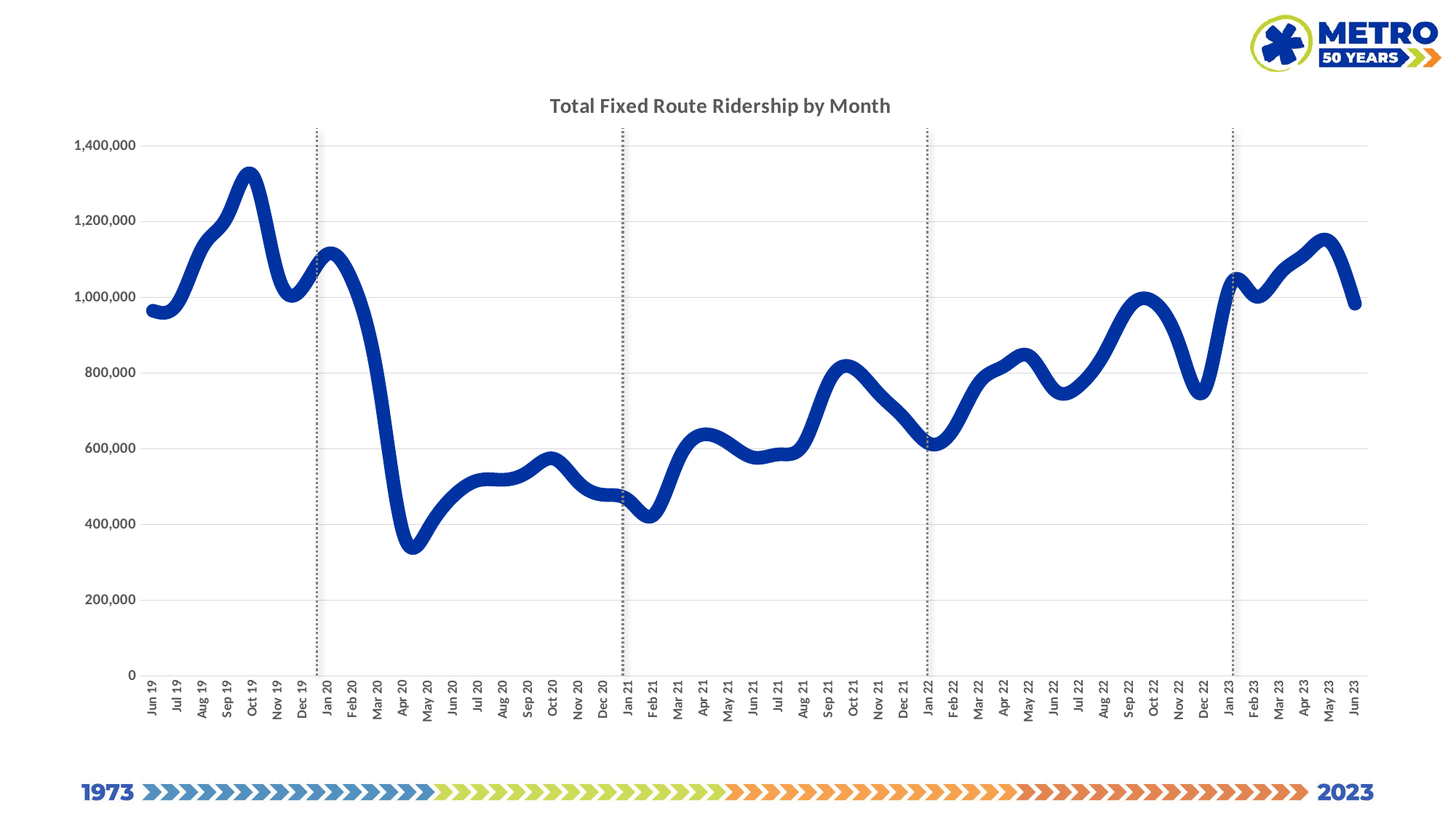
Is the value for Oct 19 greater or less than 1,200,000? greater Which month has the highest ridership? Oct 19 Is the value for Dec 22 greater or less than 800,000? less Is the value for May 23 greater or less than 1,000,000? greater Does ridership rise or fall from Jan 20 to Apr 20? fall What is the title of the chart? Total Fixed Route Ridership by Month Which is larger, the ridership in Oct 19 or in Apr 20? Oct 19 What kind of chart is shown on the slide? line chart How many months are plotted on the x axis, from Jun 19 to Jun 23? 49 Which month has the lowest ridership? Apr 20